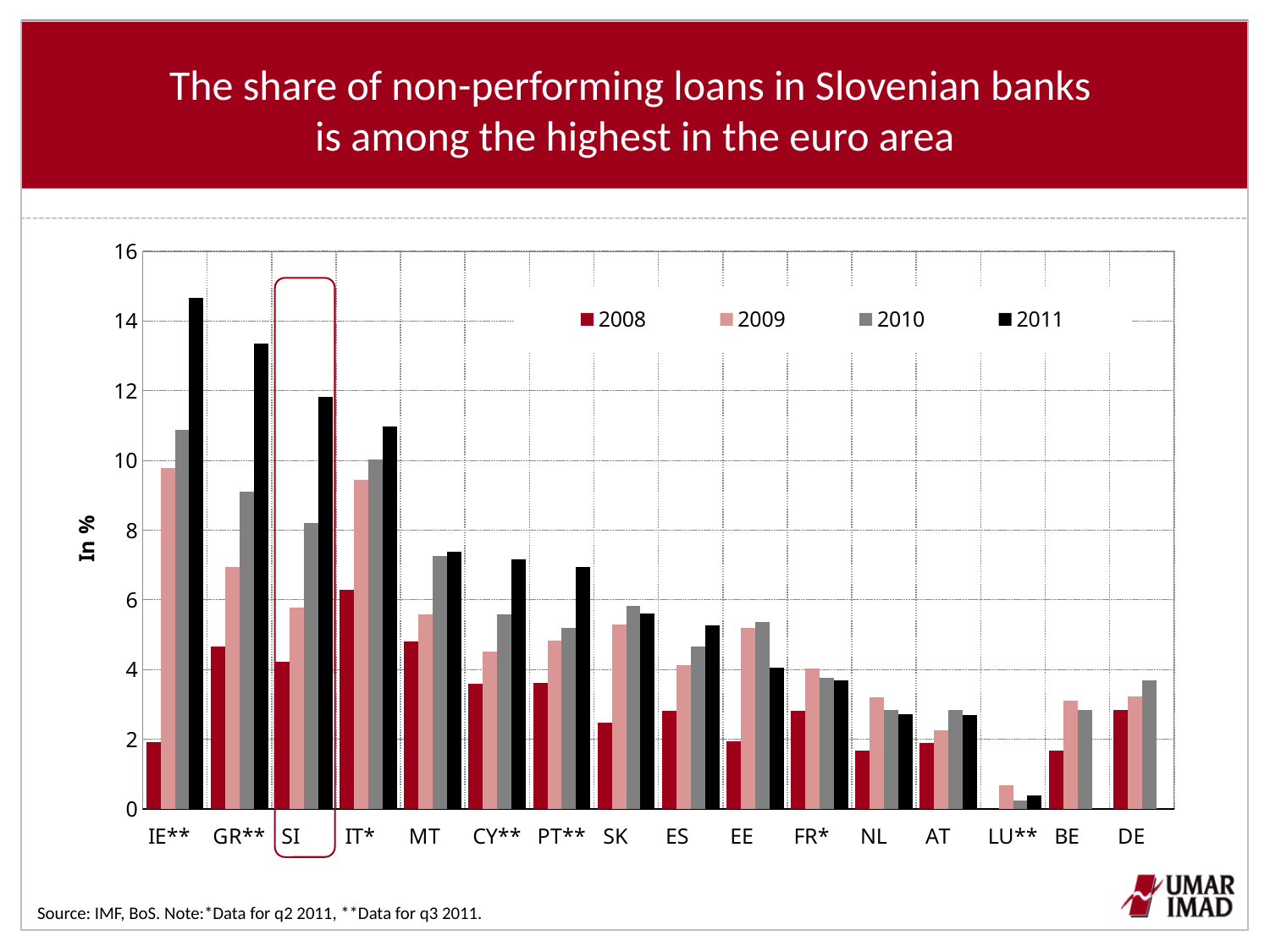
Which country has the highest value for 2011? IE** Which country is highlighted with a red outline box on the chart? SI Do the values for SI rise or fall from 2008 to 2011? rise Which is larger, the 2011 value for GR** or the 2011 value for SI? GR** Which country has the lowest value for 2009? LU** Is the value for IE** in 2011 greater or less than 14? greater What kind of chart is shown on the slide? bar chart Is the value for DE in 2010 greater or less than 4? less How many countries are shown on the x axis? 16 Is the value for IT* in 2009 greater or less than 8? greater How many series does the legend list? 4